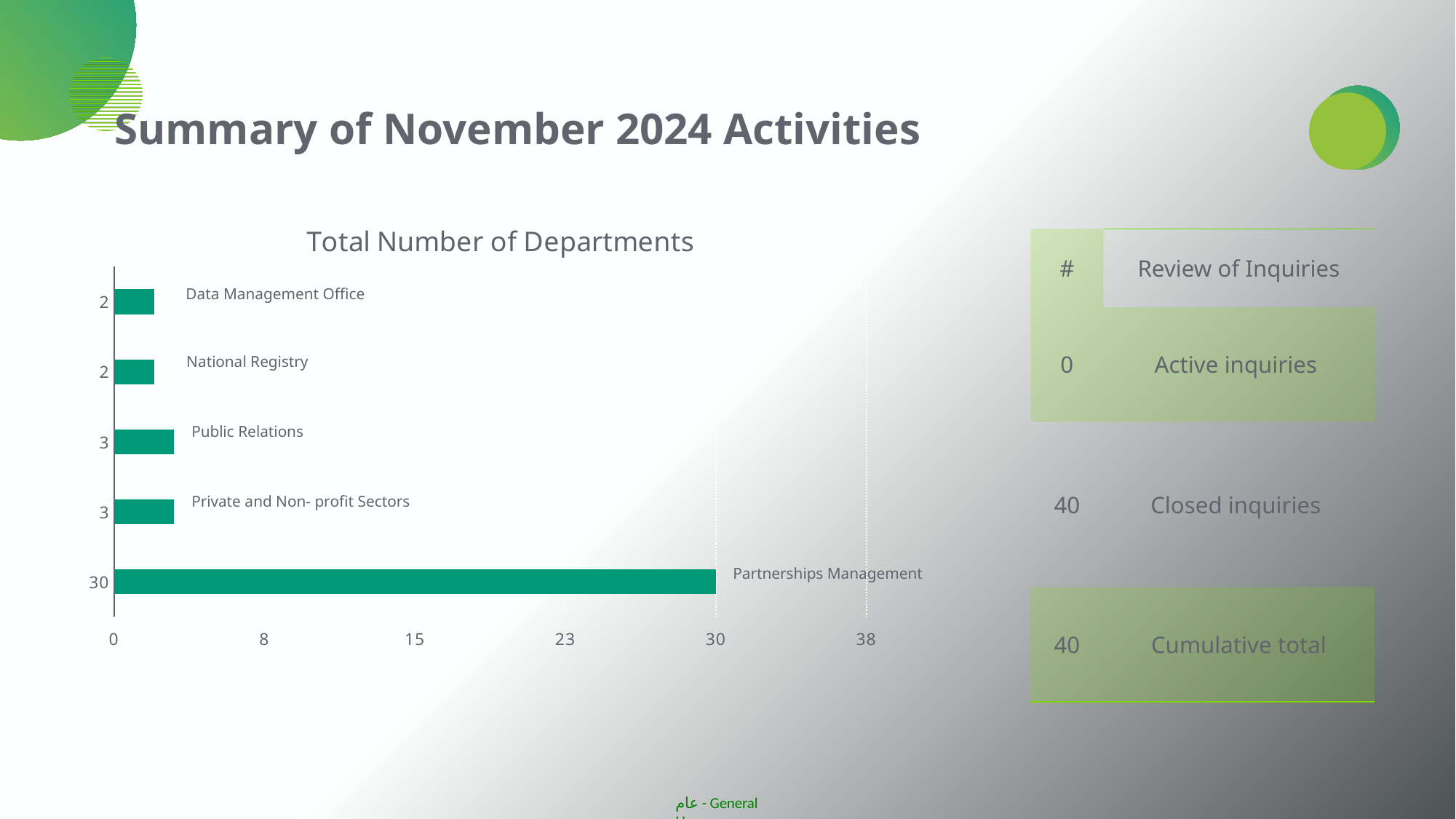
What is the value for Public Relations in the Total Number of Departments chart? 3 How many categories are shown in the Total Number of Departments chart? 5 Which category has the highest value in the Total Number of Departments chart? Partnerships Management What is the difference between the values for Partnerships Management and Public Relations in the Total Number of Departments chart? 27 What is the value for Private and Non- profit Sectors in the Total Number of Departments chart? 3 What is the difference between the values for Public Relations and National Registry in the Total Number of Departments chart? 1 Is the value for Partnerships Management in the Total Number of Departments chart greater or less than 23? greater What is the title of the chart on the slide? Total Number of Departments What is the value for Data Management Office in the Total Number of Departments chart? 2 Which is larger in the Total Number of Departments chart: the value for Partnerships Management or the value for National Registry? Partnerships Management What kind of chart is the Total Number of Departments chart? bar chart What is the value for Partnerships Management in the Total Number of Departments chart? 30